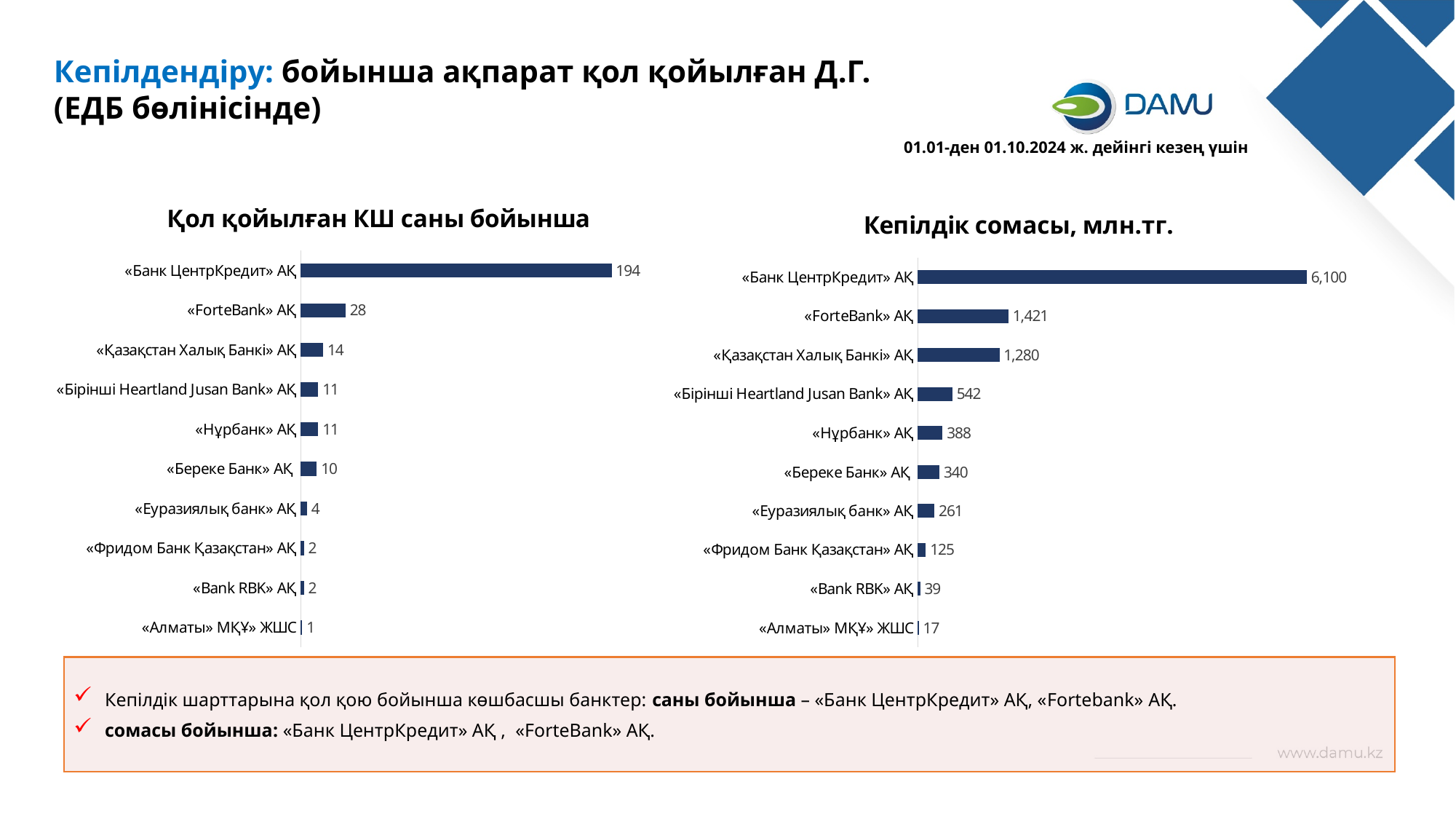
In the chart titled «Қол қойылған КШ саны бойынша», which bank has the highest value? «Банк ЦентрКредит» АҚ What kind of chart is the chart titled «Кепілдік сомасы, млн.тг.»? Bar chart What is the title of the left chart on the slide? Қол қойылған КШ саны бойынша In the chart titled «Қол қойылған КШ саны бойынша», what is the difference between «Банк ЦентрКредит» АҚ and «ForteBank» АҚ? 166 In the chart titled «Қол қойылған КШ саны бойынша», what is the value for «ForteBank» АҚ? 28 In the chart titled «Кепілдік сомасы, млн.тг.», which is larger: «Нұрбанк» АҚ or «Береке Банк» АҚ? «Нұрбанк» АҚ In the chart titled «Қол қойылған КШ саны бойынша», what is the value for «Еуразиялық банк» АҚ? 4 In the chart titled «Кепілдік сомасы, млн.тг.», what is the difference between «ForteBank» АҚ and «Қазақстан Халық Банкі» АҚ? 141 In the chart titled «Кепілдік сомасы, млн.тг.», what is the value for «Қазақстан Халық Банкі» АҚ? 1,280 In the chart titled «Кепілдік сомасы, млн.тг.», what is the value for «Банк ЦентрКредит» АҚ? 6,100 In the chart titled «Қол қойылған КШ саны бойынша», how many categories are shown? 10 In the chart titled «Кепілдік сомасы, млн.тг.», which category has the lowest value? «Алматы» МҚҰ» ЖШС